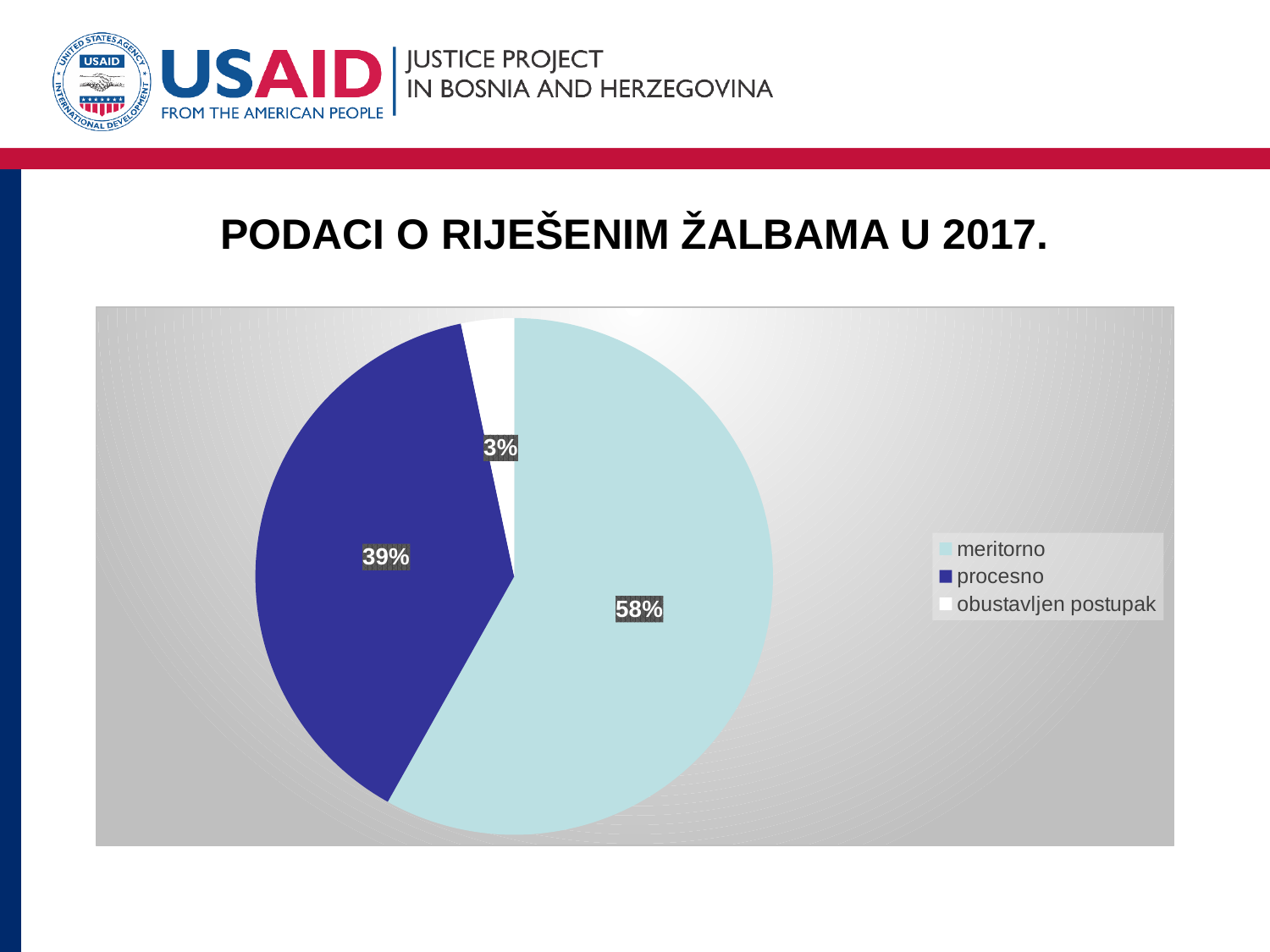
What is the title of the slide containing the chart? PODACI O RIJEŠENIM ŽALBAMA U 2017. What is the difference in percentage points between "meritorno" and "procesno"? 19 What kind of chart is shown on the slide? pie chart What share of the pie does "procesno" represent? 39% Which is larger, the share for "procesno" or the share for "obustavljen postupak"? procesno How many entries does the legend list? 3 Which category has the largest slice of the pie? meritorno Which category has the smallest slice of the pie? obustavljen postupak How many categories does the pie chart show? 3 Which legend entry is shown in dark blue? procesno What share of the pie does "meritorno" represent? 58% What share of the pie does "obustavljen postupak" represent? 3%